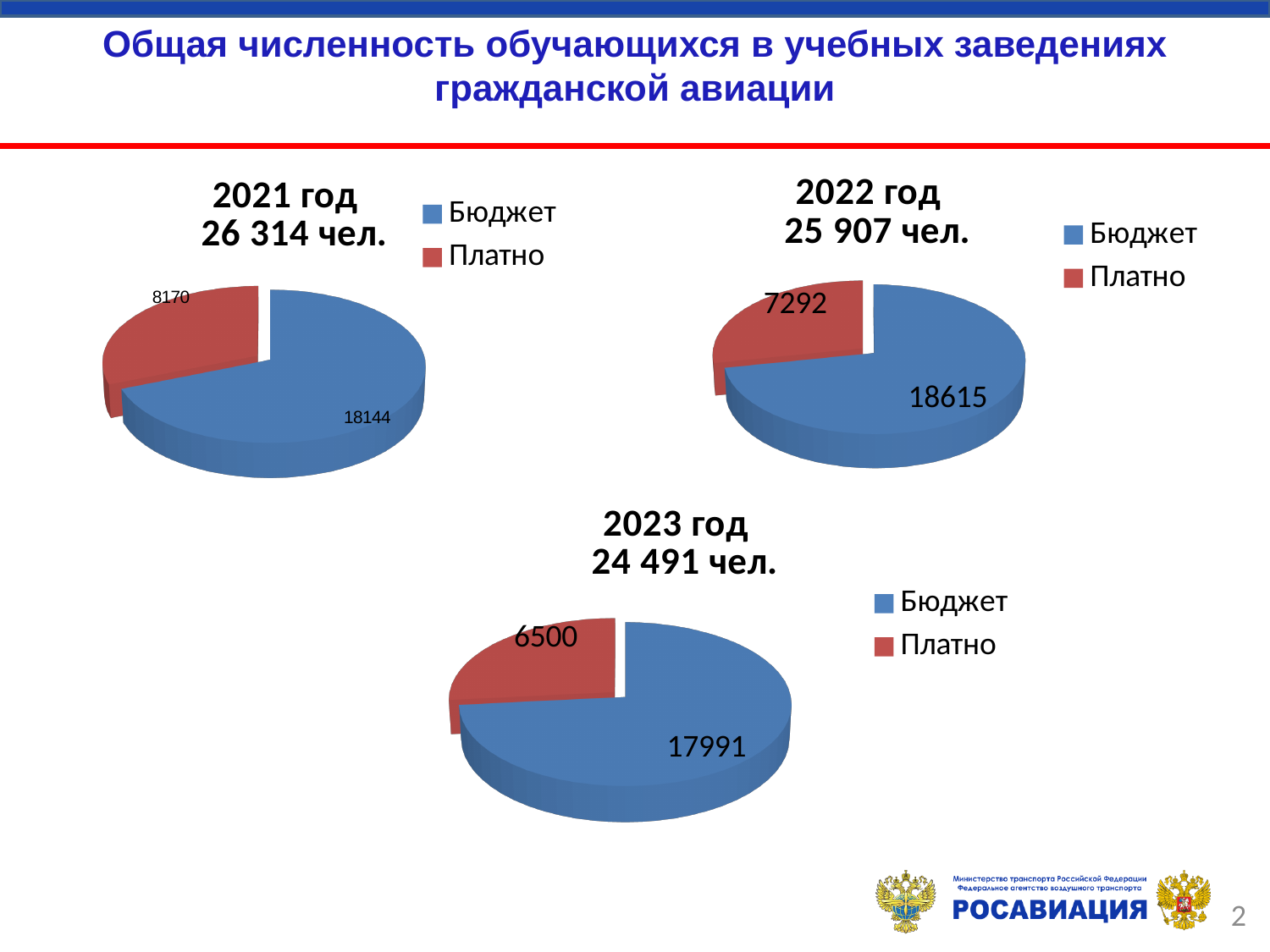
In the "2022 год" chart, what is the difference between Бюджет and Платно? 11323 In the "2022 год" chart, what is the value for Платно? 7292 In the "2021 год" chart, what is the value for Бюджет? 18144 In the "2023 год" chart, what is the value for Бюджет? 17991 In the "2023 год" chart, what is the value for Платно? 6500 In the "2022 год" chart, which category has the largest slice? Бюджет Which is larger: Платно in the "2021 год" chart or Платно in the "2023 год" chart? Платно in 2021 год In the "2023 год" chart, which category has the smallest slice? Платно How many charts are on the slide? 3 How many series does the legend of the "2022 год" chart list? 2 What kind of chart is the "2023 год" chart? Pie chart In the "2021 год" chart, what is the value for Платно? 8170